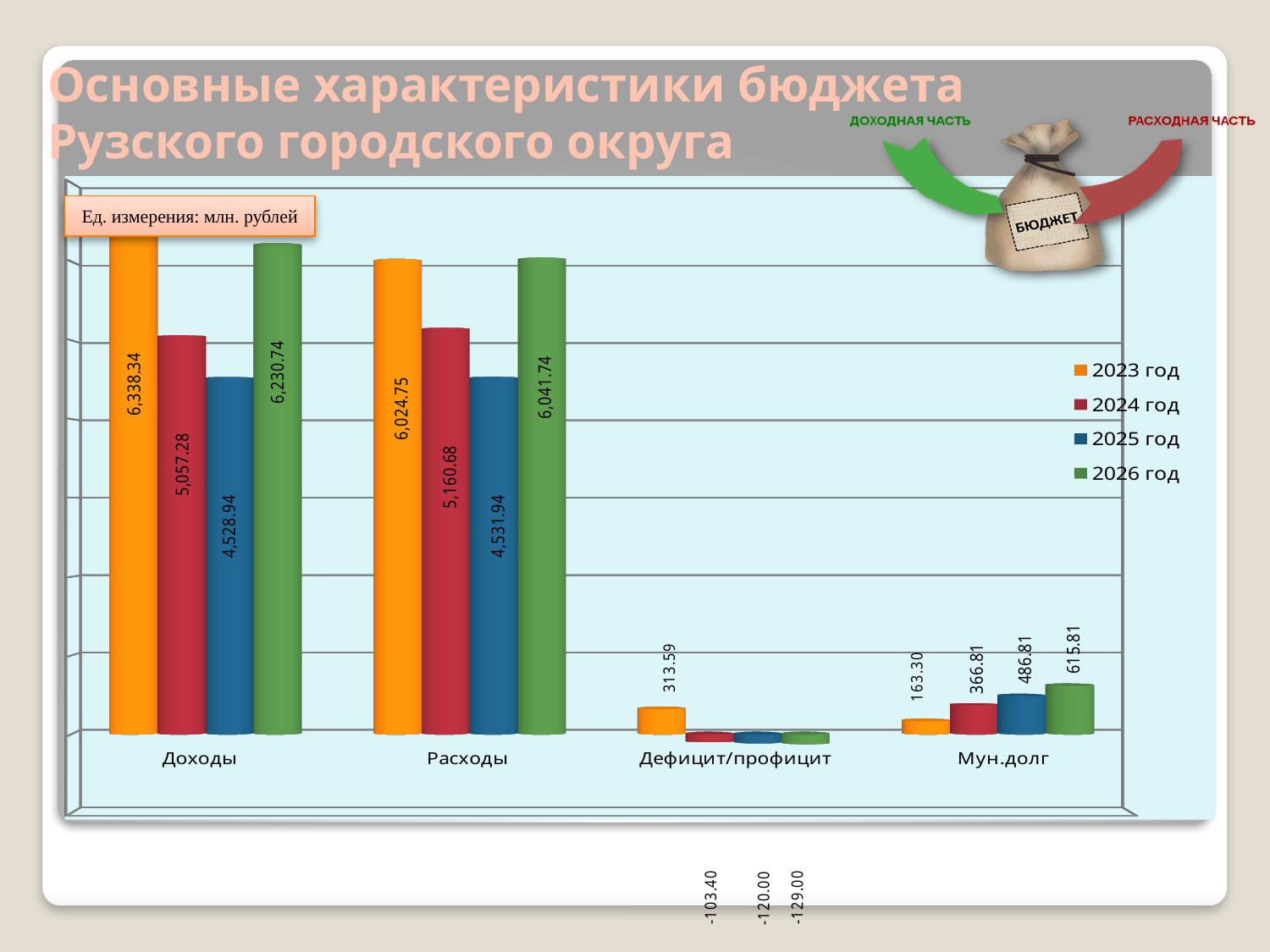
How many series does the legend list? 4 What is the value for Расходы in 2026 год? 6,041.74 Which year has the lowest value for Доходы? 2025 год What kind of chart is shown on the slide? bar chart What is the value for Дефицит/профицит in 2023 год? 313.59 How many categories are shown on the x axis? 4 What is the value for Доходы in 2023 год? 6,338.34 Which is larger, Доходы in 2023 год or Расходы in 2023 год? Доходы in 2023 год Which year has the highest value for Мун.долг? 2026 год What is the difference between Расходы and Доходы in 2024 год? 103.40 What unit of measurement is stated on the slide for the chart values? млн. рублей What is the value for Мун.долг in 2025 год? 486.81